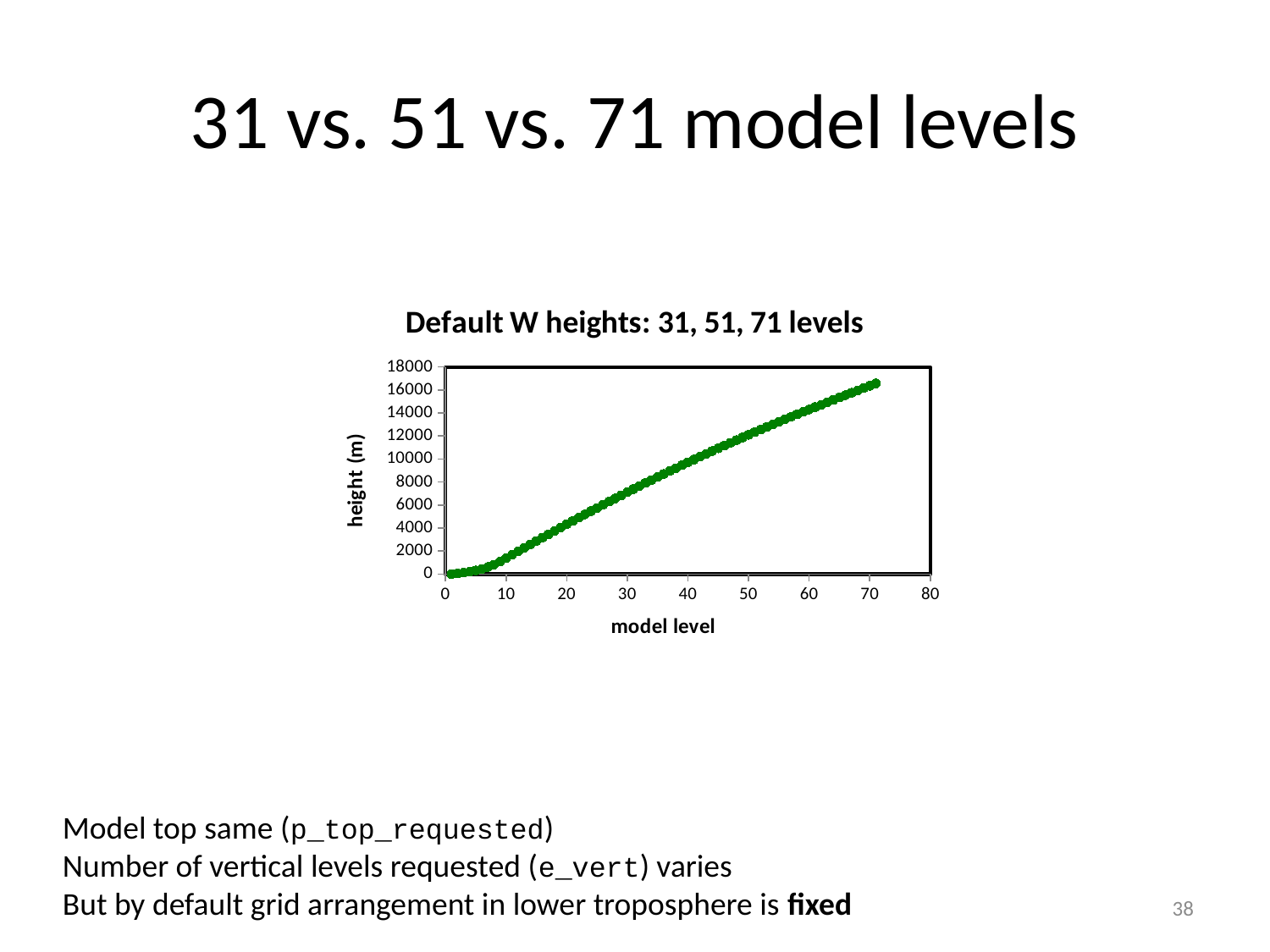
What is the title of the chart? Default W heights: 31, 51, 71 levels What is the label of the vertical axis of the chart? height (m) Is the height at model level 70 greater or less than 14000? greater Is the height at model level 40 greater or less than 12000? less Is the height at model level 60 greater or less than 10000? greater Does height rise or fall as model level increases along the x axis? rise Which has the greater height: model level 20 or model level 50? model level 50 What kind of chart is shown on the slide? scatter plot What is the highest tick value shown on the vertical axis? 18000